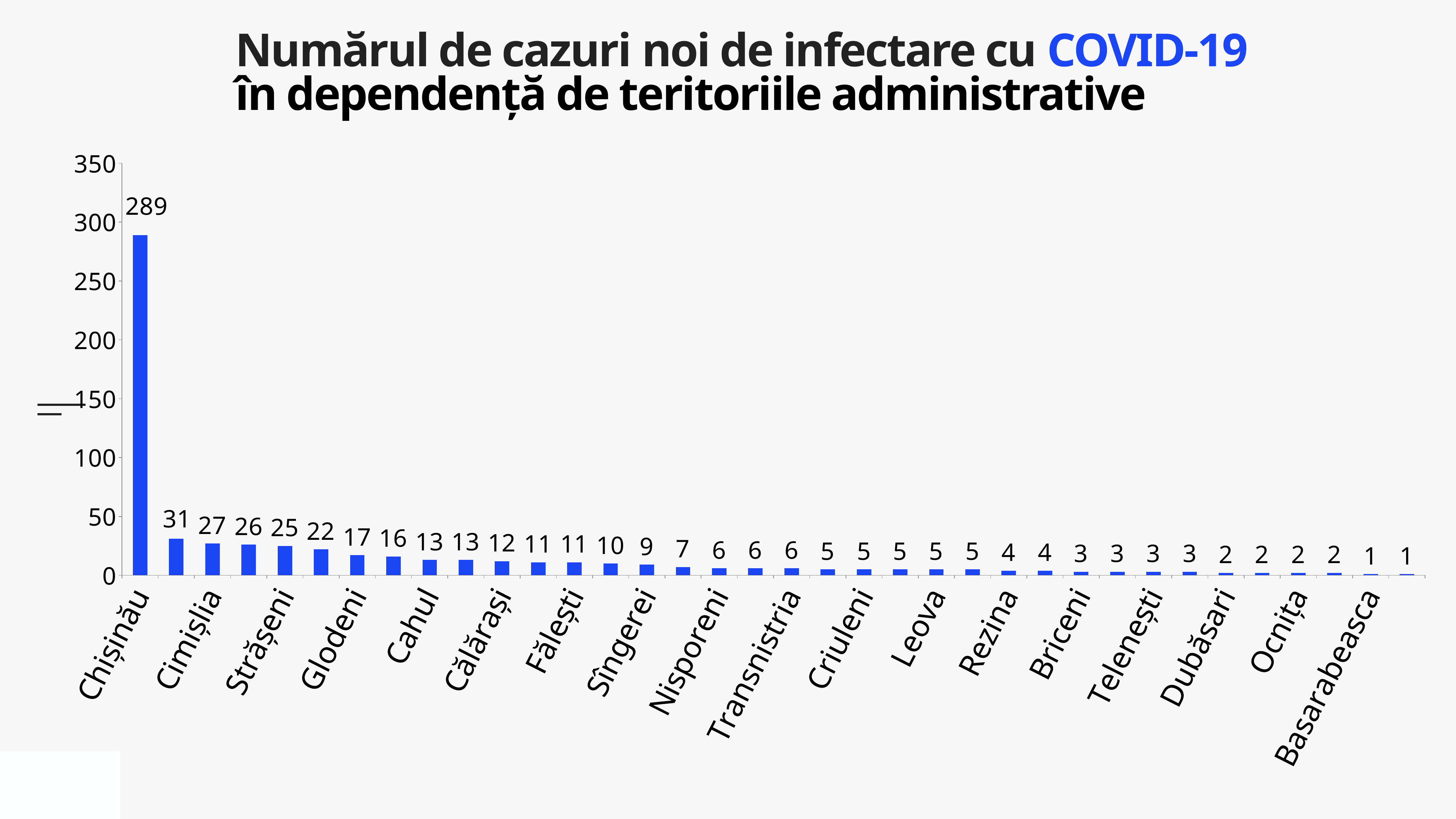
How many new COVID-19 cases are shown for Chișinău? 289 What is the difference between the values for Chișinău and Basarabeasca? 288 Which administrative territory has the highest number of new COVID-19 cases? Chișinău What is the title of the chart? Numărul de cazuri noi de infectare cu COVID-19 în dependență de teritoriile administrative Which of the labeled territories has the lowest value? Basarabeasca Which has more new cases, Chișinău or Cimișlia? Chișinău Is the value for Chișinău greater or less than 250? greater How many new COVID-19 cases are shown for Basarabeasca? 1 How many bars are plotted in the chart? 36 What type of chart is shown on the slide? bar chart Do the values rise or fall from left to right along the x axis? fall Is the value for Cimișlia greater or less than 50? less